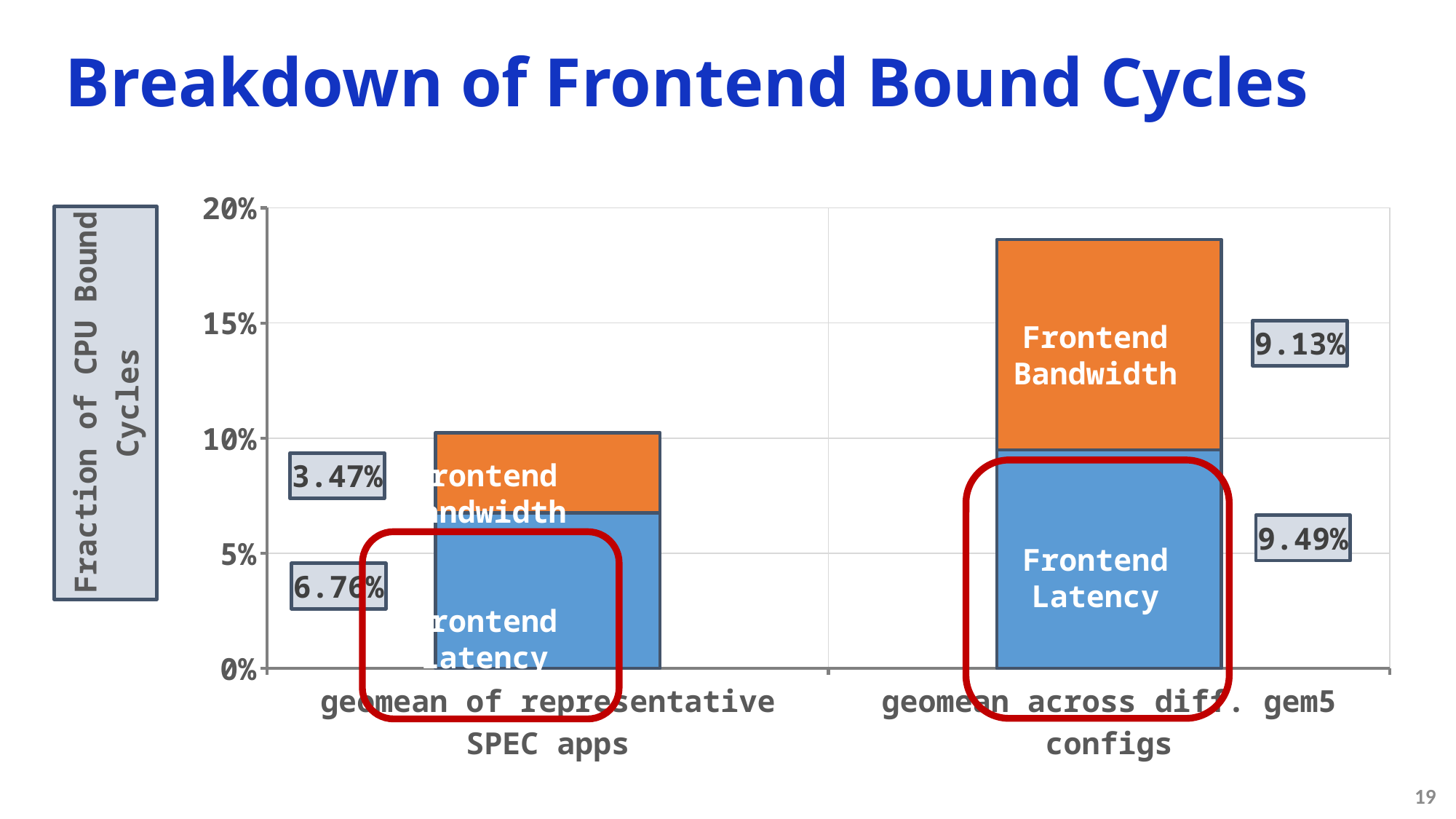
What is the Frontend Bandwidth value for the geomean of representative SPEC apps? 3.47% What is the difference between the Frontend Latency values for the gem5 configs bar and the SPEC apps bar? 2.73% What is the label of the y axis? Fraction of CPU Bound Cycles What is the difference between the Frontend Bandwidth values for the gem5 configs bar and the SPEC apps bar? 5.66% What is the Frontend Bandwidth value for the geomean across diff. gem5 configs? 9.13% How many categories are shown on the x axis? 2 What is the total height of the stacked bar for the geomean of representative SPEC apps? 10.23% What is the Frontend Latency value for the geomean of representative SPEC apps? 6.76% What is the total height of the stacked bar for the geomean across diff. gem5 configs? 18.62% What kind of chart is shown on the slide? Stacked bar chart What is the Frontend Latency value for the geomean across diff. gem5 configs? 9.49% Which category has the taller stacked bar overall? geomean across diff. gem5 configs